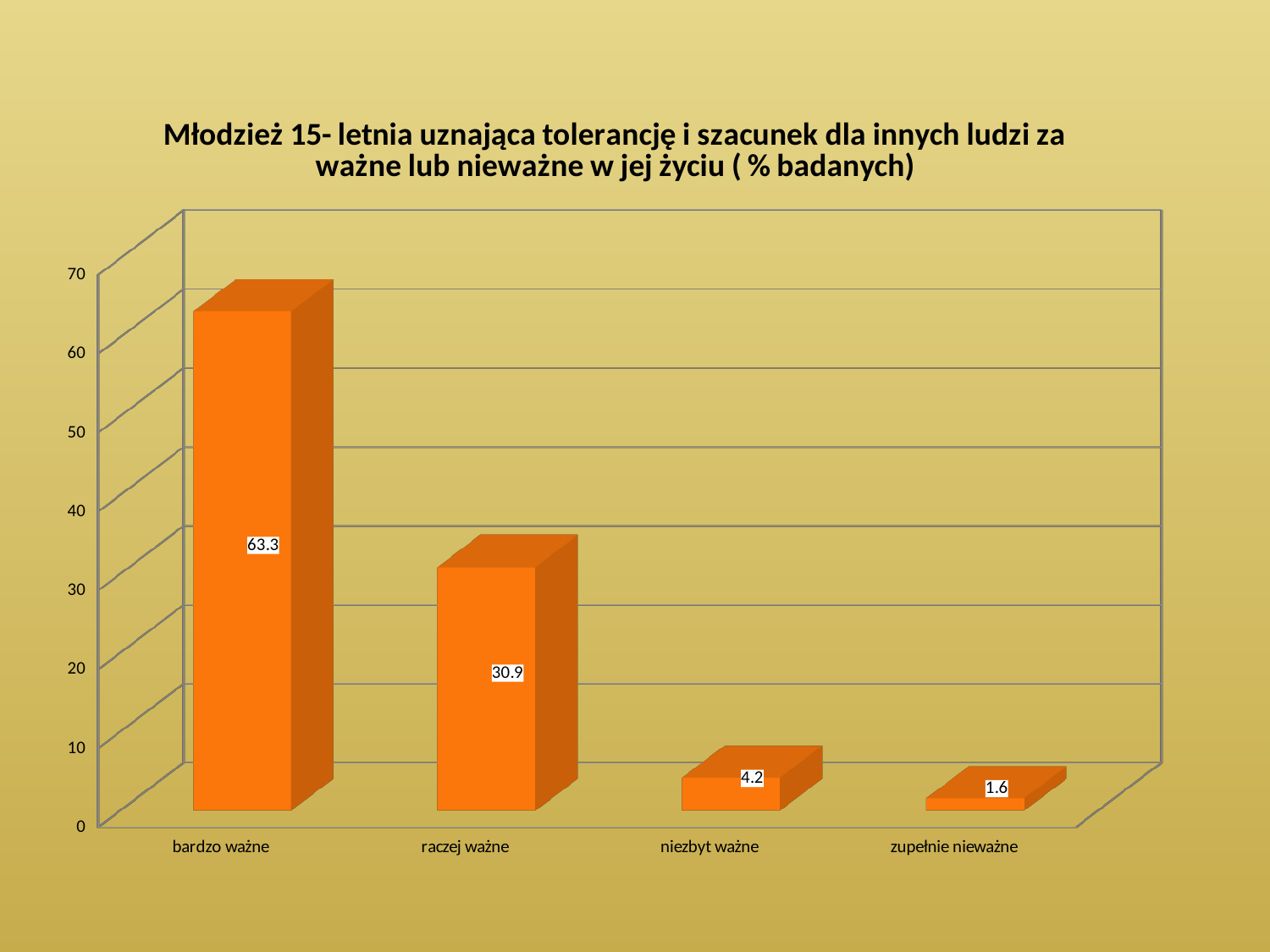
What is the difference between the values for "bardzo ważne" and "raczej ważne"? 32.4 Which category has the highest value? bardzo ważne What is the value for "bardzo ważne"? 63.3 Which is larger, the value for "niezbyt ważne" or the value for "zupełnie nieważne"? niezbyt ważne Do the values rise or fall from left to right along the x axis? fall What is the value for "niezbyt ważne"? 4.2 How many categories are shown on the x axis? 4 What is the value for "zupełnie nieważne"? 1.6 Which category has the lowest value? zupełnie nieważne What kind of chart is shown on the slide? bar chart What is the value for "raczej ważne"? 30.9 Is the value for "raczej ważne" greater or less than 40? less